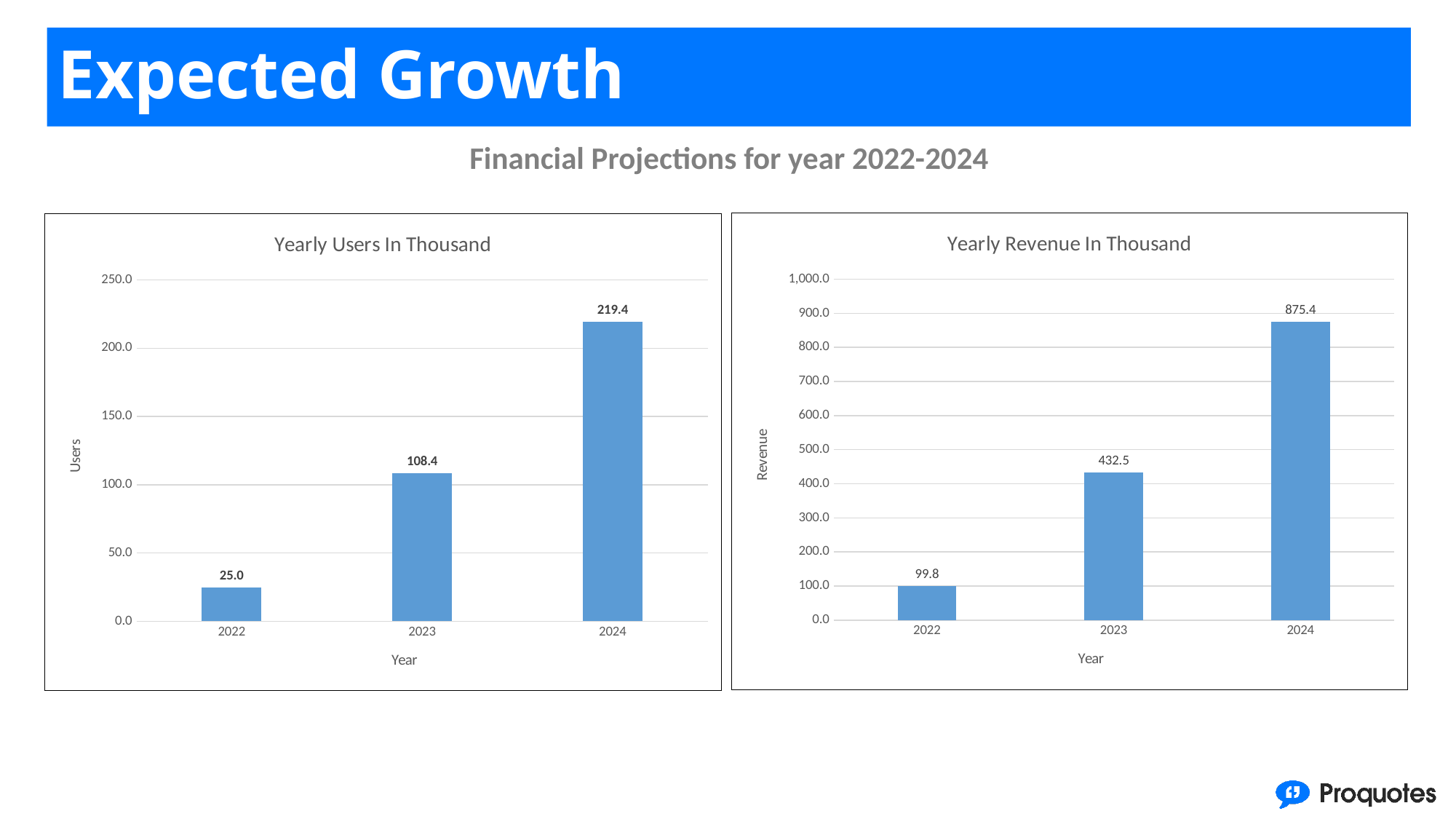
In the 'Yearly Revenue In Thousand' chart, what is the value for 2022? 99.8 In the 'Yearly Users In Thousand' chart, which year has the highest value? 2024 In the 'Yearly Revenue In Thousand' chart, what is the value for 2024? 875.4 In the 'Yearly Users In Thousand' chart, which is larger, the value for 2022 or the value for 2023? 2023 In the 'Yearly Revenue In Thousand' chart, which year has the lowest value? 2022 How many years are shown on the x axis of the 'Yearly Users In Thousand' chart? 3 In the 'Yearly Users In Thousand' chart, do the values rise or fall from 2022 to 2024? rise In the 'Yearly Revenue In Thousand' chart, is the value for 2023 greater or less than 400.0? greater In the 'Yearly Users In Thousand' chart, what is the value for 2023? 108.4 In the 'Yearly Users In Thousand' chart, what is the difference between the 2024 and 2022 values? 194.4 What kind of chart is the 'Yearly Revenue In Thousand' chart? bar chart In the 'Yearly Revenue In Thousand' chart, what is the difference between the 2024 and 2023 values? 442.9